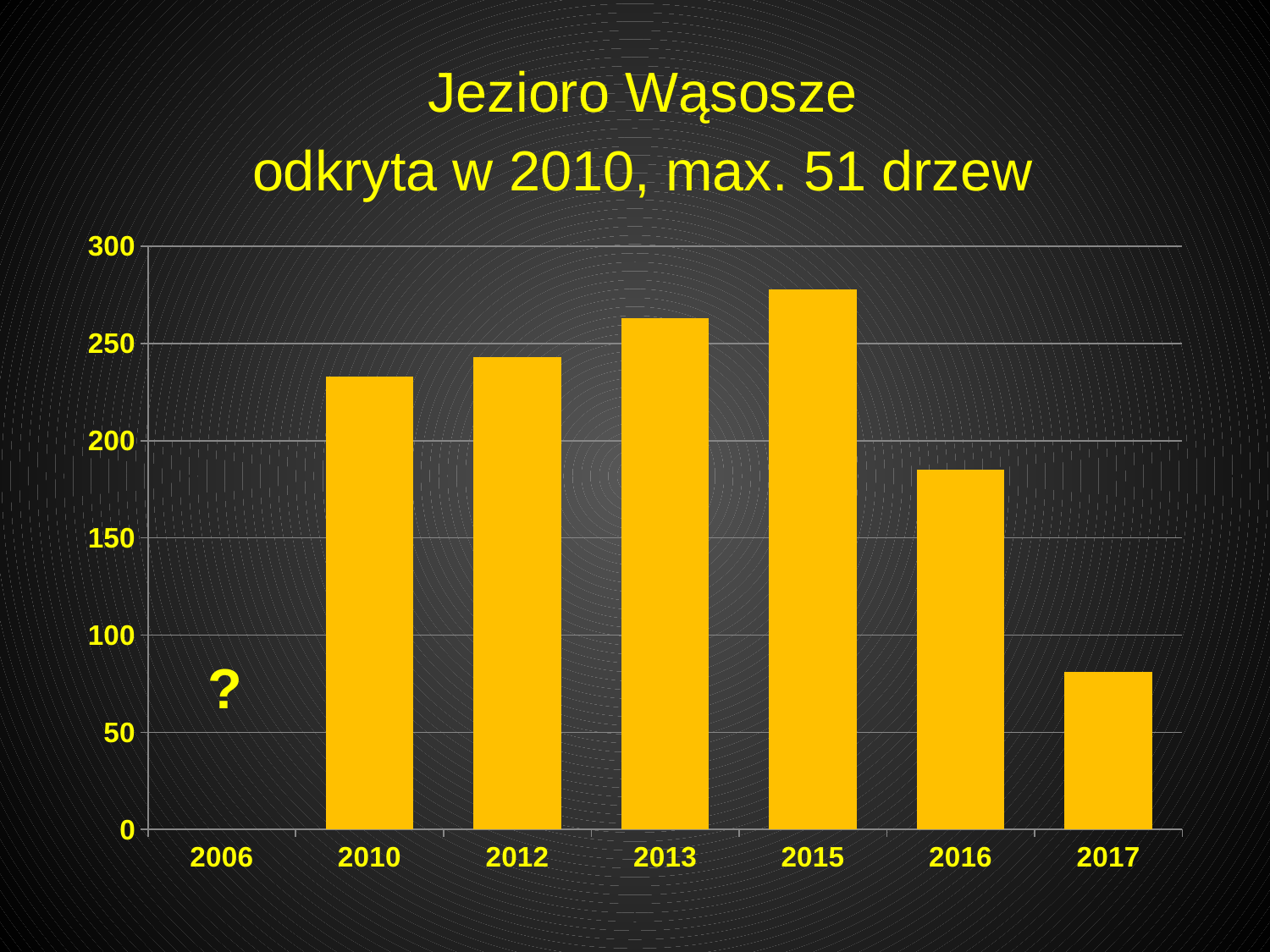
What is shown in place of a bar for 2006? a question mark (?) Do the values rise or fall from 2015 to 2017? fall Which year has the highest bar? 2015 Is the value for 2013 greater or less than 250? greater Which is larger, the value for 2013 or the value for 2016? 2013 Is the value for 2015 greater or less than 250? greater What kind of chart is shown on the slide? bar chart Is the value for 2016 greater or less than 200? less How many bars are plotted on the chart? 6 Which year has the lowest bar among the plotted bars? 2017